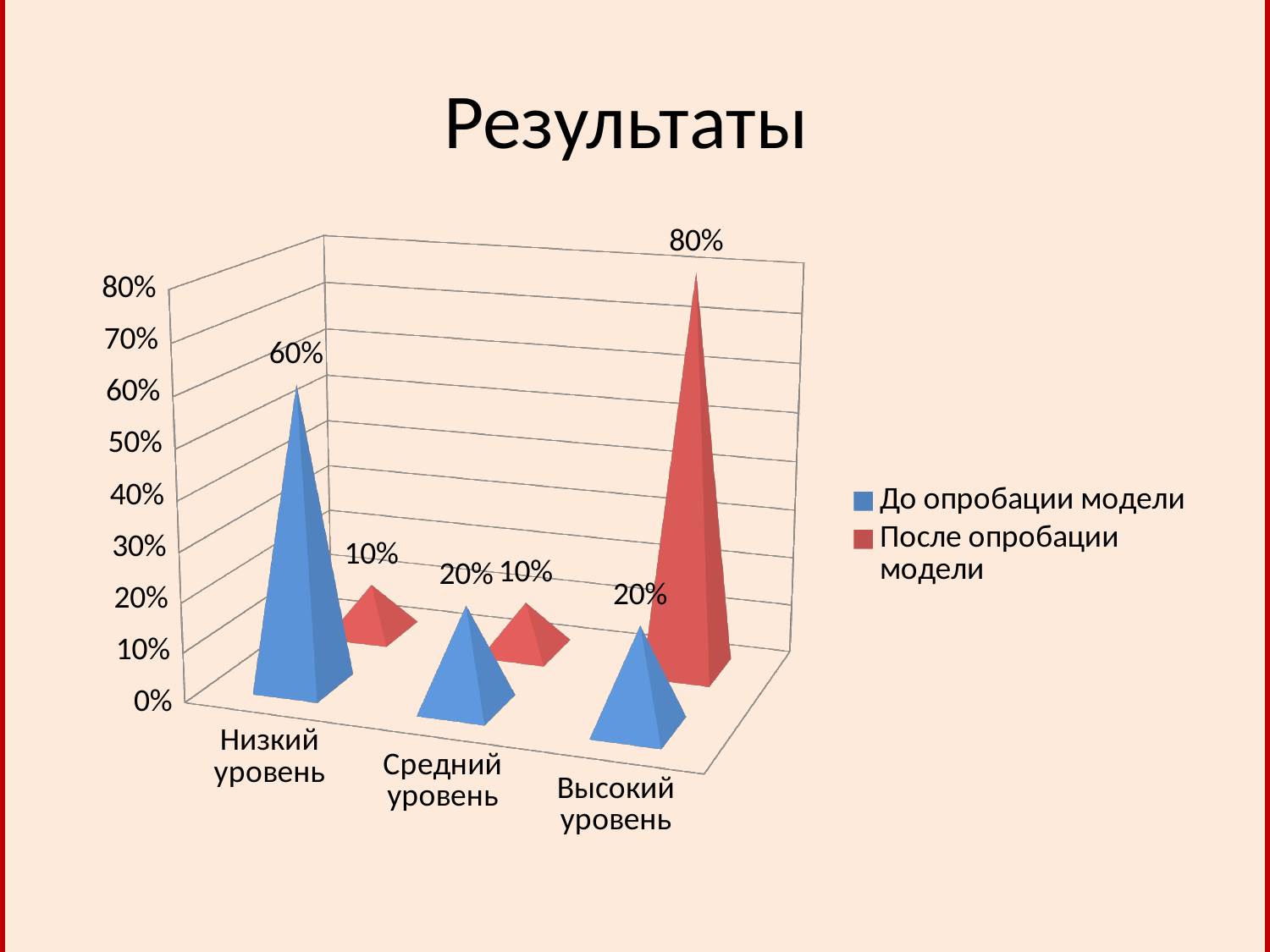
For Низкий уровень, which series has the larger value: До опробации модели or После опробации модели? До опробации модели What is the value for Высокий уровень in the После опробации модели series? 80% How many series does the legend list? 2 Which category has the highest value in the После опробации модели series? Высокий уровень What is the value for Низкий уровень in the До опробации модели series? 60% Which category has the lowest value in the До опробации модели series? Средний уровень and Высокий уровень (both 20%) What is the title of the slide? Результаты How many categories are shown on the x axis? 3 What kind of chart is shown on the slide? Bar chart What is the difference between the После опробации модели and До опробации модели values for Высокий уровень? 60% What is the value for Высокий уровень in the До опробации модели series? 20% What is the value for Средний уровень in the После опробации модели series? 10%